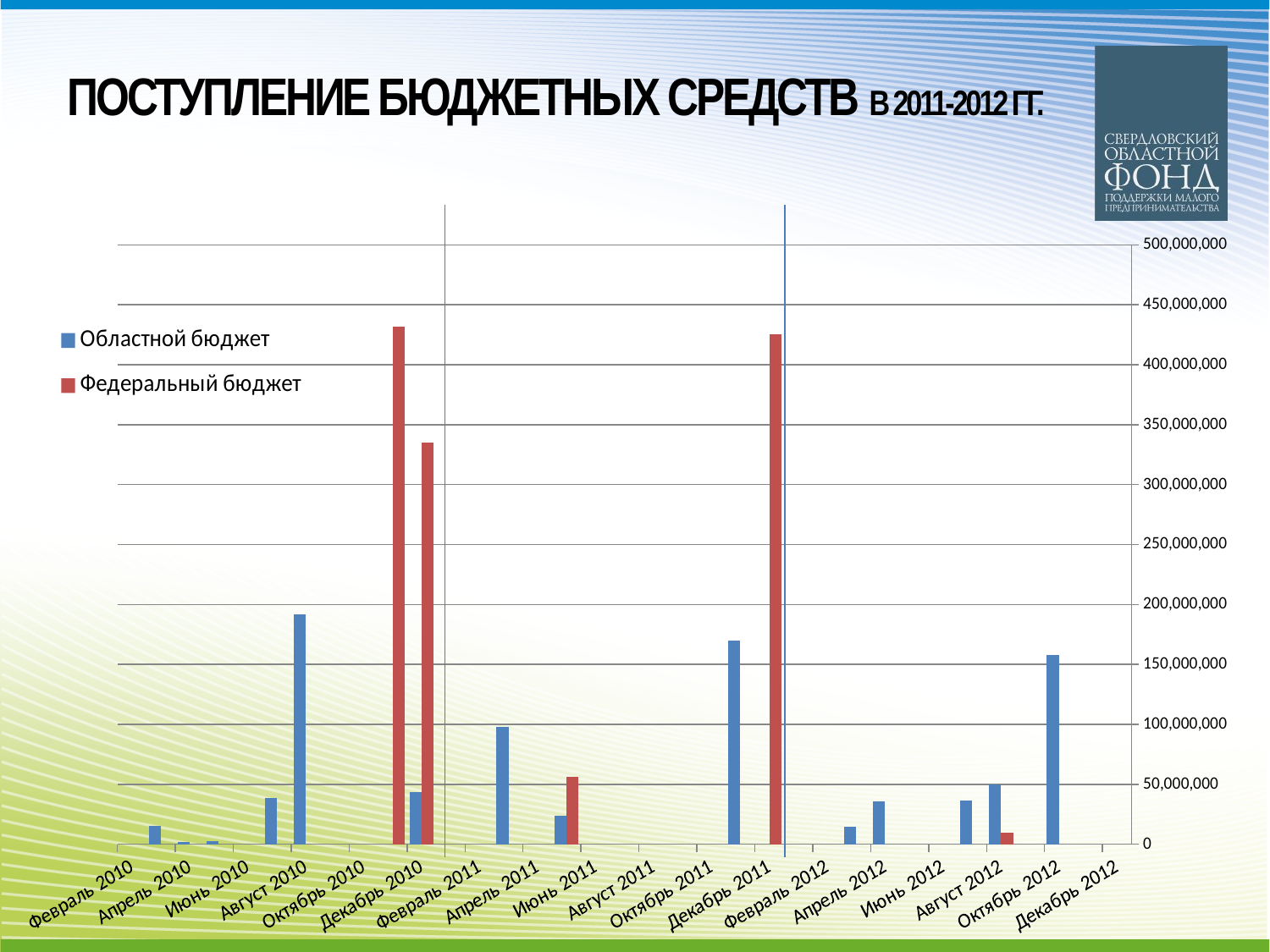
Which series contains the tallest bar on the chart? Федеральный бюджет Which is larger: the tallest Федеральный бюджет bar or the tallest Областной бюджет bar? the tallest Федеральный бюджет bar What is the title of the chart on the slide? ПОСТУПЛЕНИЕ БЮДЖЕТНЫХ СРЕДСТВ В 2011-2012 ГГ. Is the tallest Областной бюджет bar greater or less than 150,000,000? greater What are the two series named in the legend? Областной бюджет and Федеральный бюджет What kind of chart is shown on the slide? bar chart How many category labels are shown along the x axis? 18 Is the tallest Областной бюджет bar greater or less than 250,000,000? less Is the tallest Федеральный бюджет bar greater or less than 400,000,000? greater How many series does the legend list? 2 How many Федеральный бюджет bars are plotted on the chart? 5 What is the highest value shown on the y axis? 500,000,000